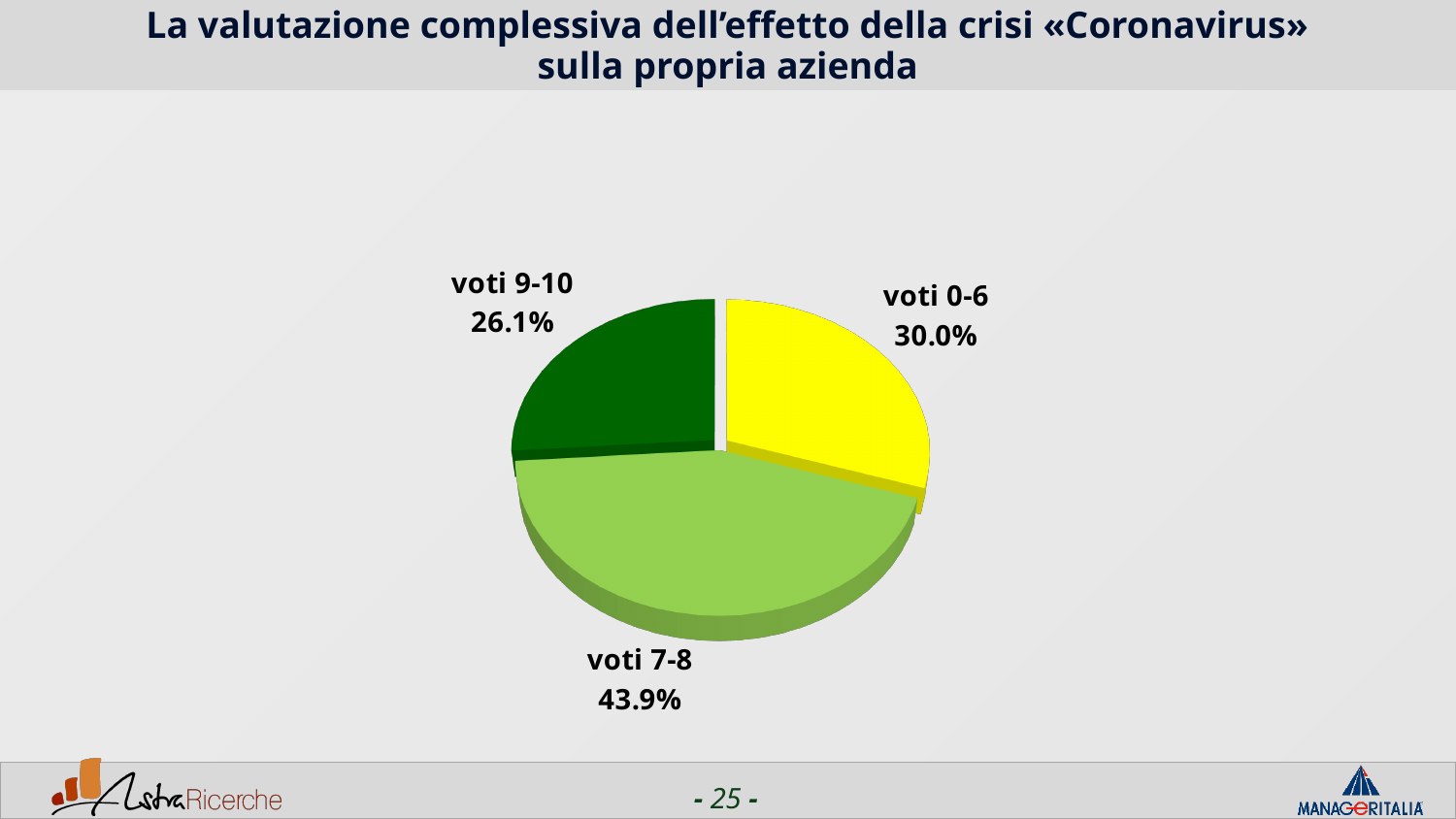
What is the title of the slide? La valutazione complessiva dell'effetto della crisi «Coronavirus» sulla propria azienda Which category has the smallest slice of the pie? voti 9-10 What kind of chart is shown on the slide? pie chart How many slices does the pie chart have? 3 What share of the pie is labelled "voti 0-6"? 30.0% What is the difference in percentage points between "voti 7-8" and "voti 0-6"? 13.9 What is the difference in percentage points between "voti 0-6" and "voti 9-10"? 3.9 Which category has the largest slice of the pie? voti 7-8 What colour is the slice for "voti 0-6"? yellow What share of the pie is labelled "voti 9-10"? 26.1% Which is larger, the slice for "voti 0-6" or the slice for "voti 9-10"? voti 0-6 What share of the pie is labelled "voti 7-8"? 43.9%